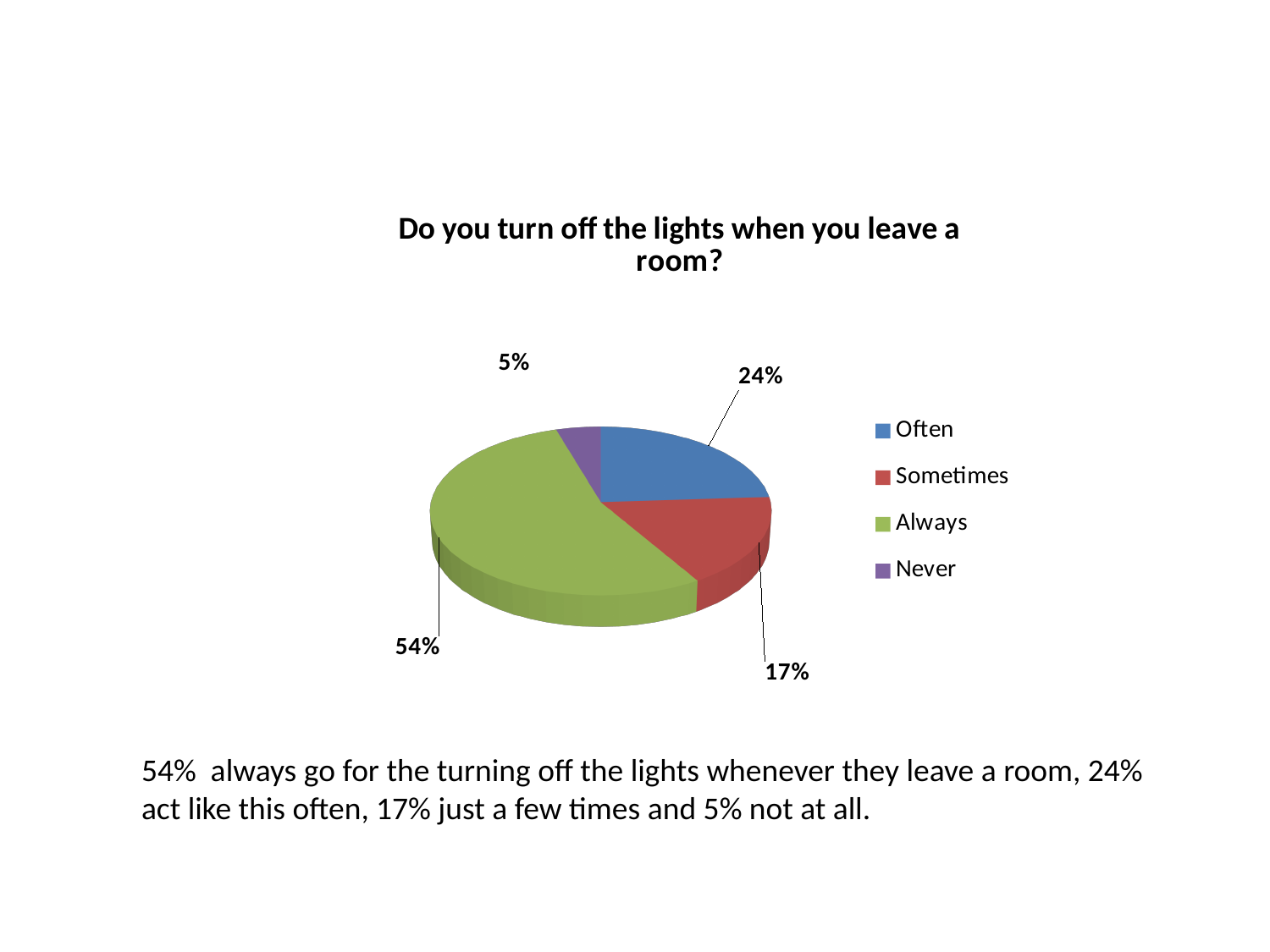
What is the title of the chart? Do you turn off the lights when you leave a room? Which category has the largest slice of the pie? Always What kind of chart is shown on the slide? Pie chart Which is larger, the Often slice or the Sometimes slice? Often What is the value shown for Often? 24% What is the value shown for Never? 5% What share of the pie does the Always slice represent? 54% What is the value shown for Sometimes? 17% How many categories does the pie chart show? 4 What is the difference in percentage points between Often and Sometimes? 7 What is the difference in percentage points between Always and Often? 30 Which category has the smallest slice of the pie? Never